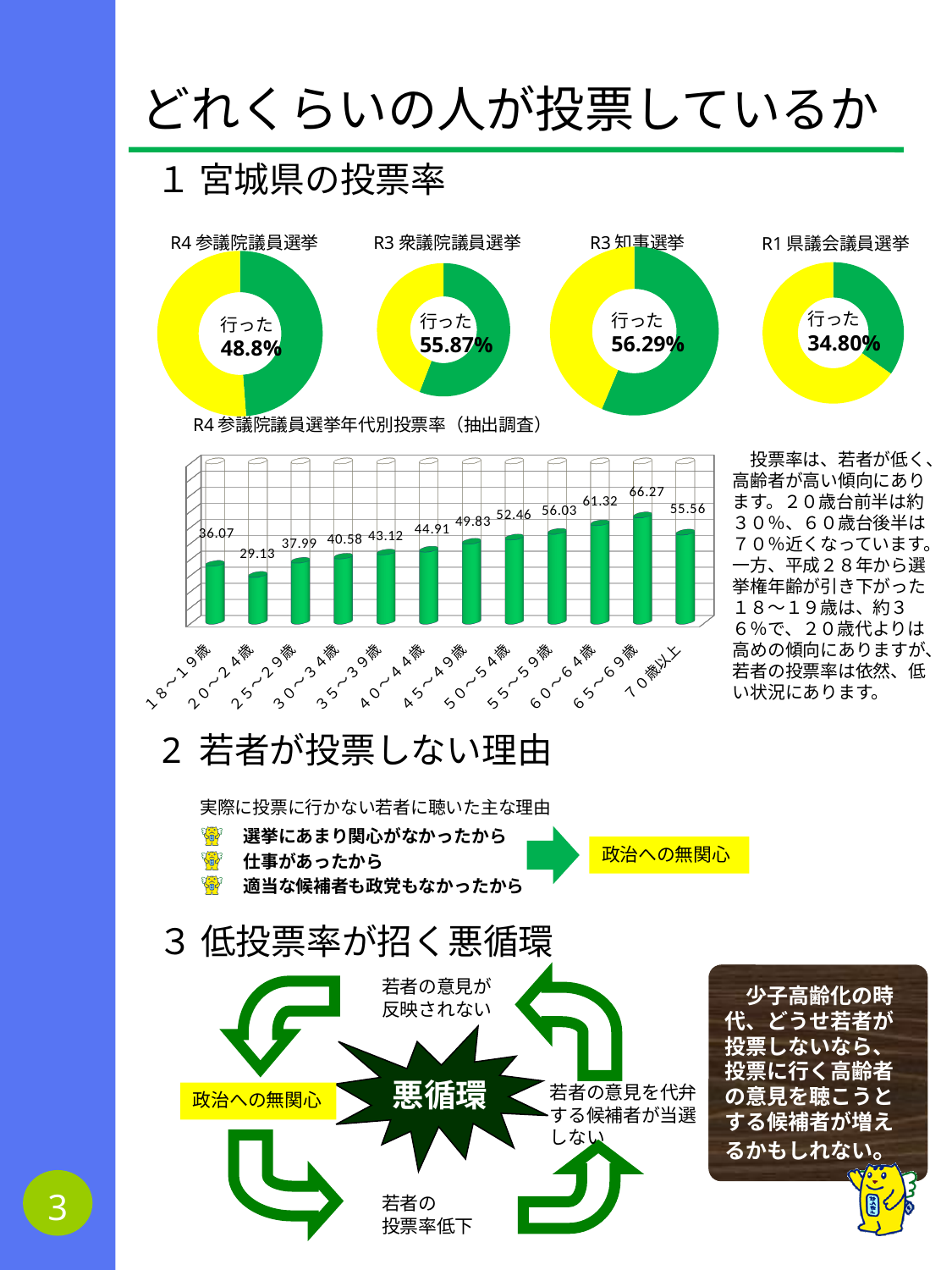
In the R1 県議会議員選挙 donut chart, what is the 行った percentage? 34.80% What kind of chart is the R4 参議院議員選挙年代別投票率（抽出調査）chart? Bar chart In the bar chart R4 参議院議員選挙年代別投票率（抽出調査）, what is the value for 18～19歳? 36.07 In the bar chart R4 参議院議員選挙年代別投票率（抽出調査）, which age group has the lowest value? 20～24歳 Among the four donut charts, which election has the lowest 行った percentage? R1 県議会議員選挙 What is the difference between the 行った percentage in the R3 知事選挙 donut chart and the R3 衆議院議員選挙 donut chart? 0.42% In the bar chart R4 参議院議員選挙年代別投票率（抽出調査）, how many age groups are shown? 12 Among the four donut charts (R4 参議院議員選挙, R3 衆議院議員選挙, R3 知事選挙, R1 県議会議員選挙), which election has the highest 行った percentage? R3 知事選挙 In the bar chart R4 参議院議員選挙年代別投票率（抽出調査）, what is the difference between the values for 65～69歳 and 70歳以上? 10.71 In the R4 参議院議員選挙 donut chart, what percentage of people 行った (voted)? 48.8% In the bar chart R4 参議院議員選挙年代別投票率（抽出調査）, which age group has the highest value? 65～69歳 In the bar chart R4 参議院議員選挙年代別投票率（抽出調査）, what is the value for 20～24歳? 29.13